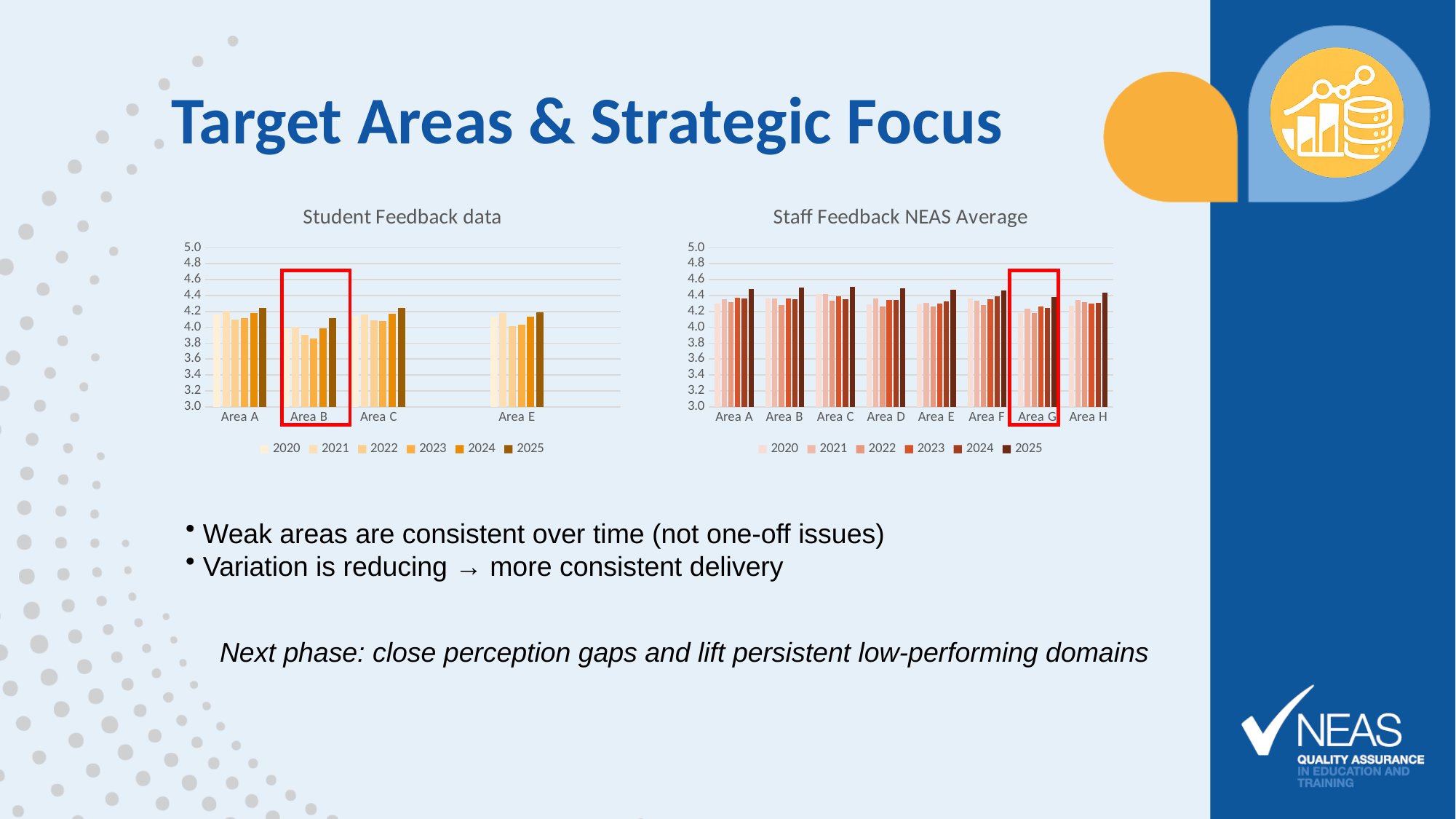
How many area categories are labelled on the x axis of the Student Feedback data chart? 4 In the Student Feedback data chart, which area has the lowest 2022 value? Area B Which area is outlined with a red box in the Staff Feedback NEAS Average chart? Area G In the Student Feedback data chart, which is larger: the 2025 value for Area A or the 2025 value for Area B? Area A In the Student Feedback data chart, is the 2022 value for Area B greater or less than 4.0? less In the Student Feedback data chart, is the 2025 value for Area B greater or less than 4.0? greater How many series does the legend of the Staff Feedback NEAS Average chart list? 6 What kind of chart is the Student Feedback data chart? bar chart In the Staff Feedback NEAS Average chart, is the 2025 value for Area G greater or less than 4.2? greater In the Staff Feedback NEAS Average chart, which area has the lowest 2021 value? Area G How many area categories are labelled on the x axis of the Staff Feedback NEAS Average chart? 8